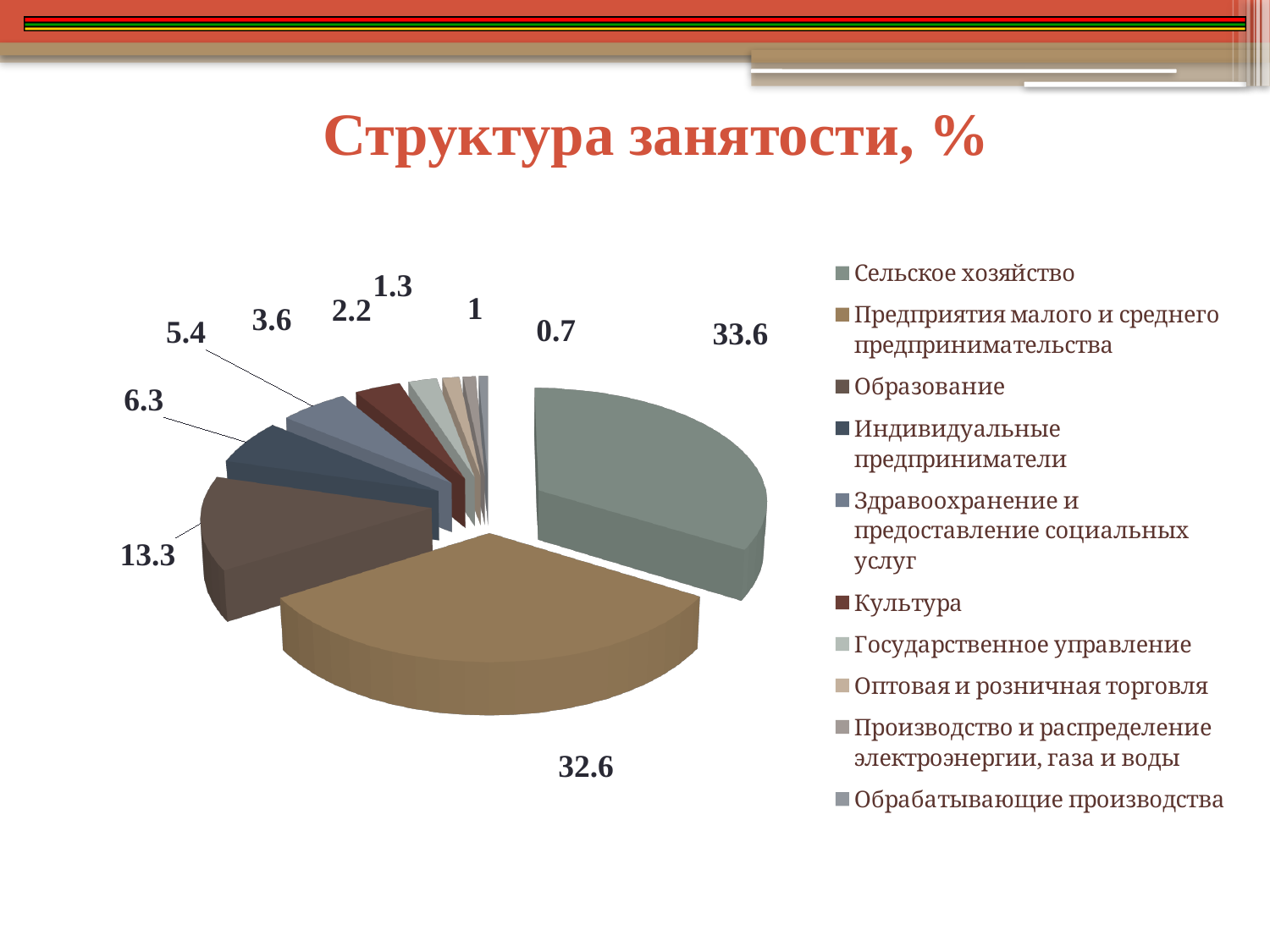
How many categories does the legend of the pie chart list? 10 What is the value for Индивидуальные предприниматели? 6.3 What kind of chart is shown on the slide? pie chart What is the difference between the values for Сельское хозяйство and Предприятия малого и среднего предпринимательства? 1 What is the value for Сельское хозяйство? 33.6 What is the title of the chart? Структура занятости, % Which category has the smallest share of the pie? Обрабатывающие производства What is the value for Культура? 3.6 What is the value for Предприятия малого и среднего предпринимательства? 32.6 Which category has the largest share of the pie? Сельское хозяйство What is the value for Образование? 13.3 Which is larger, the value for Образование or the value for Здравоохранение и предоставление социальных услуг? Образование